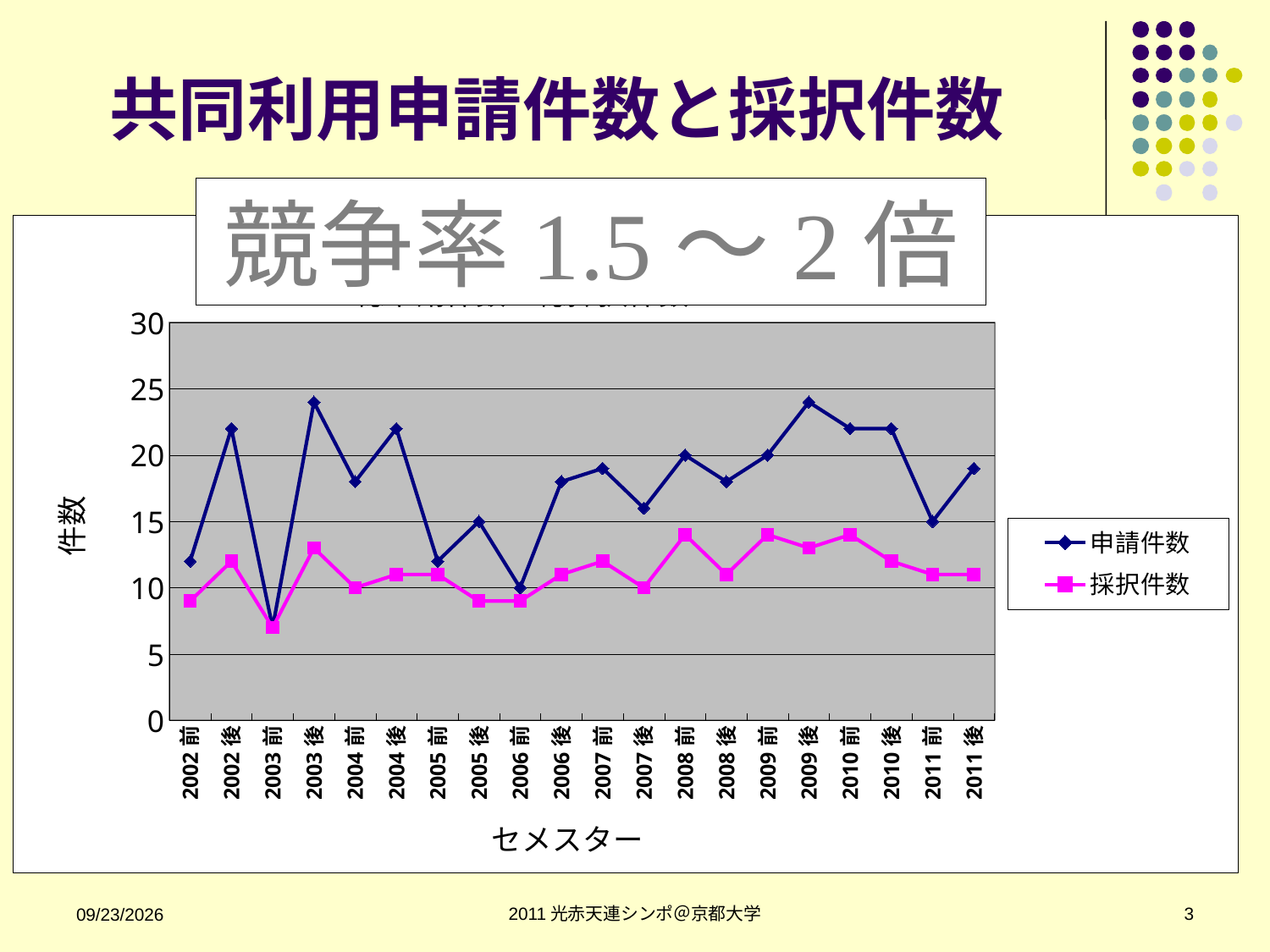
What is the value of 申請件数 for 2006 前? 10 Is the value of 採択件数 for 2008 前 greater or less than 15? less What is the value of 採択件数 for 2004 前? 10 What is the title of the x axis? セメスター Is the value of 採択件数 for 2003 前 greater or less than 10? less What kind of chart is shown on the slide? line chart For 2009 後, which series has the larger value, 申請件数 or 採択件数? 申請件数 Which semester has the lowest value of 申請件数? 2003 前 How many semesters are plotted along the x axis? 20 What is the value of 申請件数 for 2005 後? 15 How many series does the legend list? 2 Is the value of 申請件数 for 2003 後 greater or less than 20? greater